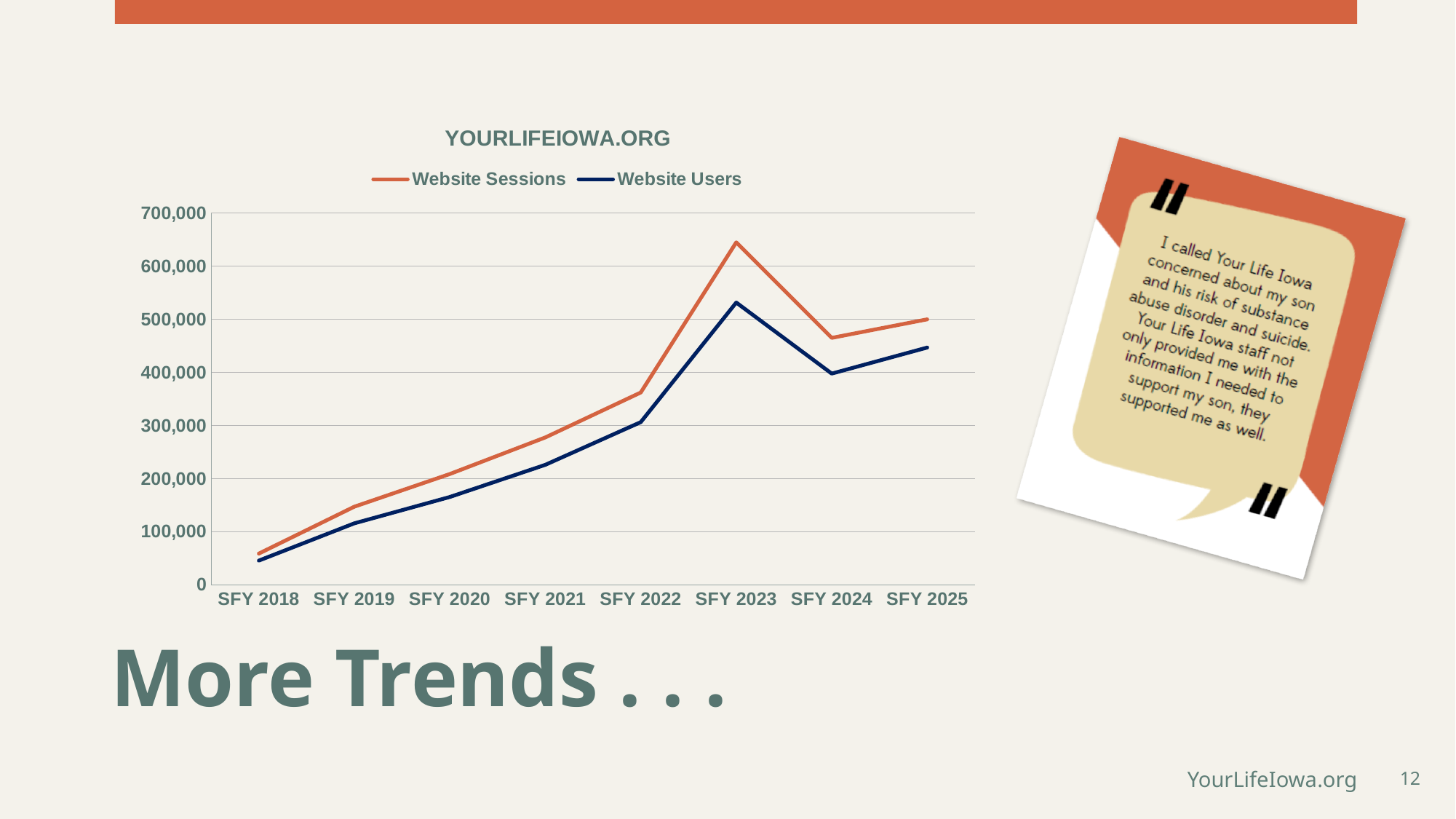
What kind of chart is shown on the slide? line chart Is the value for Website Sessions in SFY 2023 greater or less than 600,000? greater How many series does the legend list? 2 In which fiscal year is Website Sessions highest? SFY 2023 Is the value for Website Sessions in SFY 2018 greater or less than 100,000? less Do the Website Users values rise or fall from SFY 2018 to SFY 2023? rise In which fiscal year is Website Users lowest? SFY 2018 How many fiscal years are plotted on the x axis? 8 What is the title of the chart? YOURLIFEIOWA.ORG Which is larger in SFY 2024, Website Sessions or Website Users? Website Sessions Is the value for Website Users in SFY 2023 greater or less than 500,000? greater